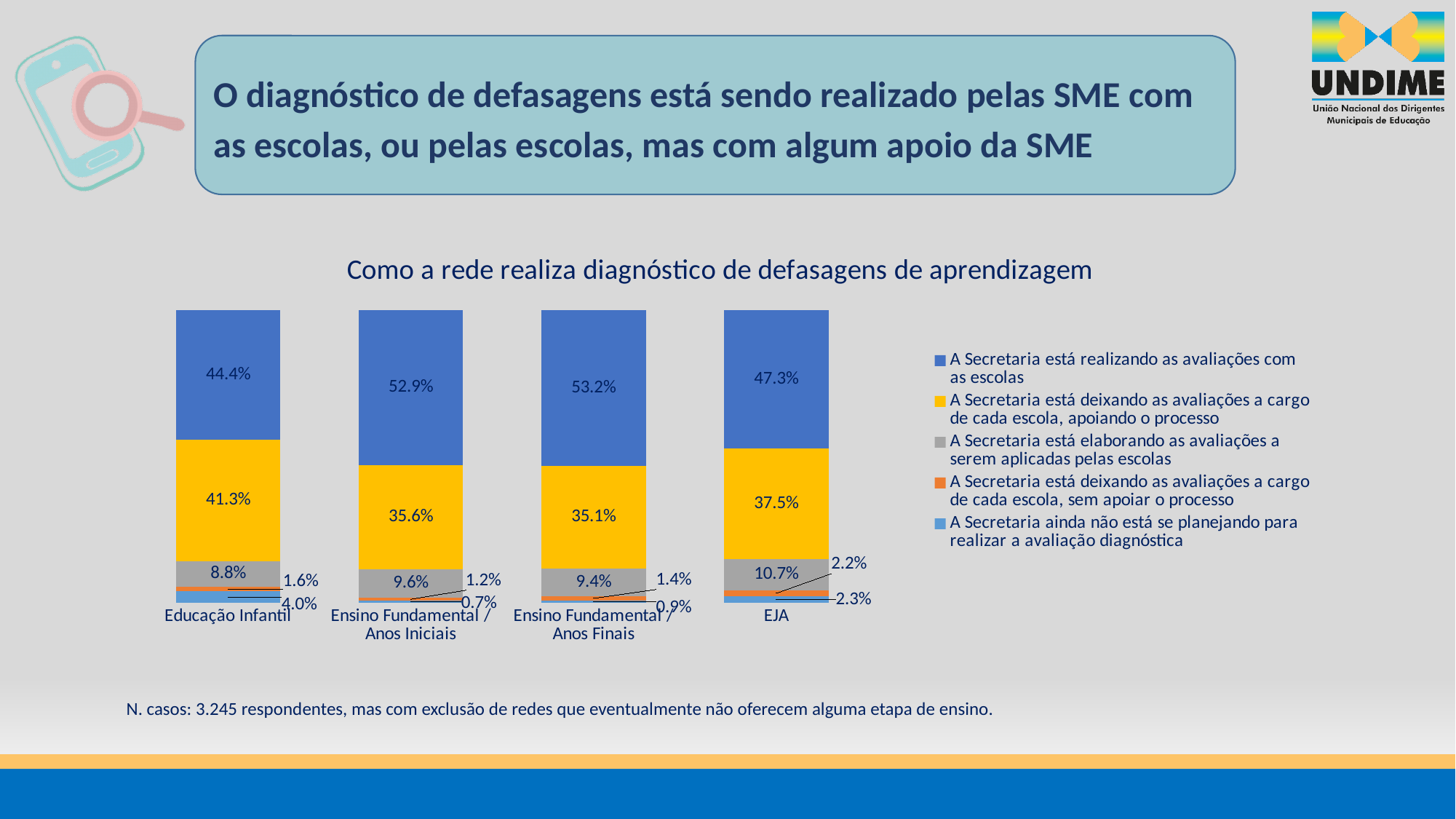
What type of chart is shown on the slide? Stacked bar chart What is the difference between the "A Secretaria está realizando as avaliações com as escolas" values for Ensino Fundamental / Anos Iniciais and Educação Infantil? 8.5% Which category has the highest value for "A Secretaria está realizando as avaliações com as escolas"? Ensino Fundamental / Anos Finais How many series does the chart legend list? 5 What is the value for EJA in the series "A Secretaria está deixando as avaliações a cargo de cada escola, apoiando o processo"? 37.5% What percentage of respondents for Ensino Fundamental / Anos Iniciais said the Secretaria is carrying out the assessments with the schools ("A Secretaria está realizando as avaliações com as escolas")? 52.9% What is the value for Educação Infantil in the series "A Secretaria está elaborando as avaliações a serem aplicadas pelas escolas"? 8.8% What is the title of the chart? Como a rede realiza diagnóstico de defasagens de aprendizagem Which category has the lowest value for "A Secretaria está elaborando as avaliações a serem aplicadas pelas escolas"? Educação Infantil How many categories (education stages) are shown on the x axis of the chart? 4 Which is larger for Educação Infantil: the share for "A Secretaria está realizando as avaliações com as escolas" or the share for "A Secretaria está deixando as avaliações a cargo de cada escola, apoiando o processo"? A Secretaria está realizando as avaliações com as escolas What is the value for Ensino Fundamental / Anos Finais in the series "A Secretaria está realizando as avaliações com as escolas"? 53.2%